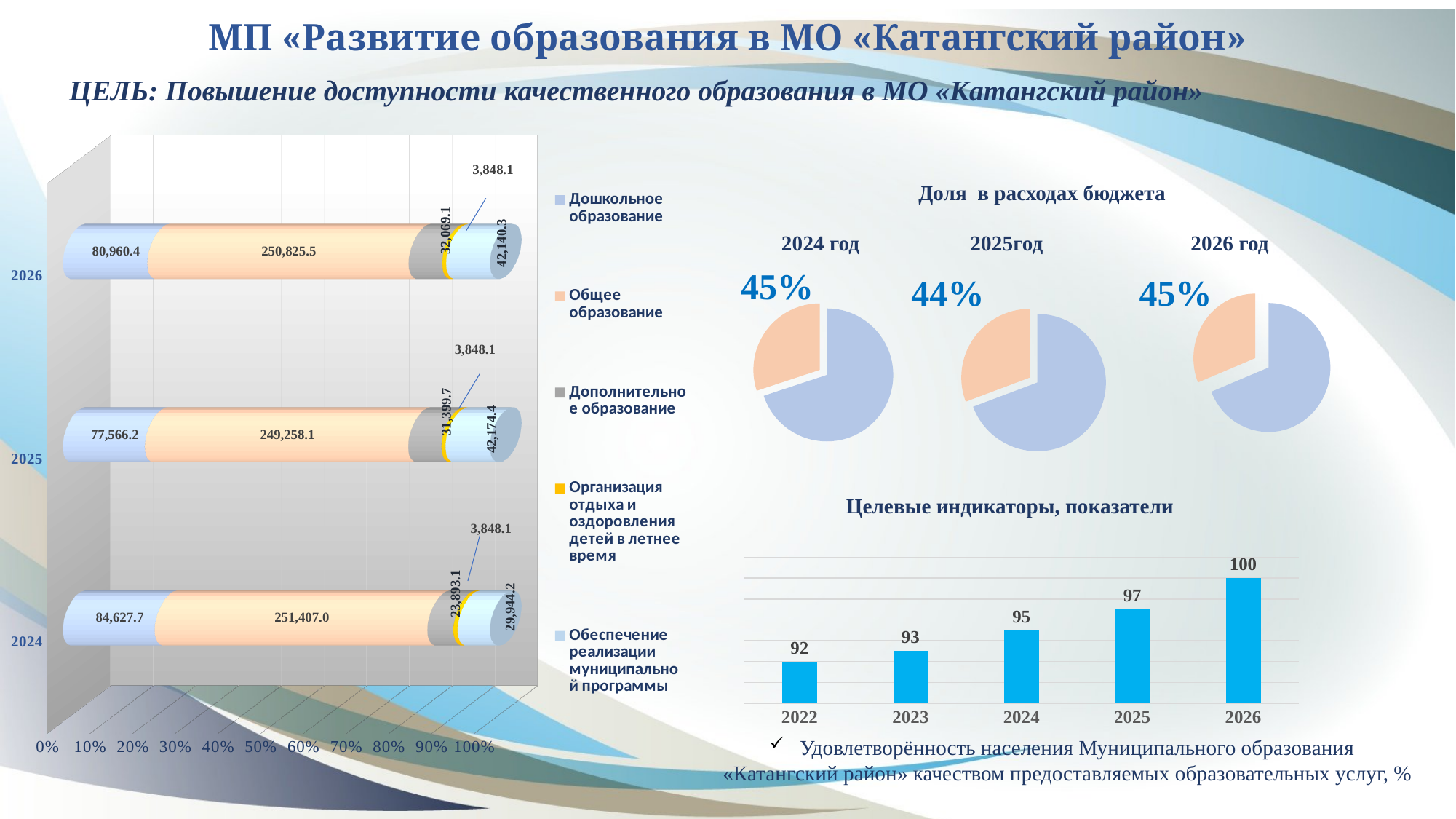
In the 'Целевые индикаторы, показатели' bar chart, do the values rise or fall from 2022 to 2026? Rise In the pie charts under 'Доля в расходах бюджета', what share is shown for 2025? 44% In the stacked bar chart on the left, which year has the highest value for Дошкольное образование? 2024 In the stacked bar chart on the left, what is the value for Организация отдыха и оздоровления детей в летнее время in 2025? 3,848.1 How many series does the legend of the stacked bar chart on the left list? 5 In the 'Целевые индикаторы, показатели' bar chart, what is the value for 2024? 95 What kind of chart is the chart on the left of the slide? Bar chart In the stacked bar chart on the left, what is the value for Дошкольное образование in 2024? 84,627.7 In the pie charts under 'Доля в расходах бюджета', which year has the lowest share? 2025 In the stacked bar chart on the left, what is the value for Общее образование in 2026? 250,825.5 In the 'Целевые индикаторы, показатели' bar chart, what is the difference between the values for 2026 and 2022? 8 In the stacked bar chart on the left, what is the difference between the Дополнительное образование values for 2026 and 2024? 8,176.0